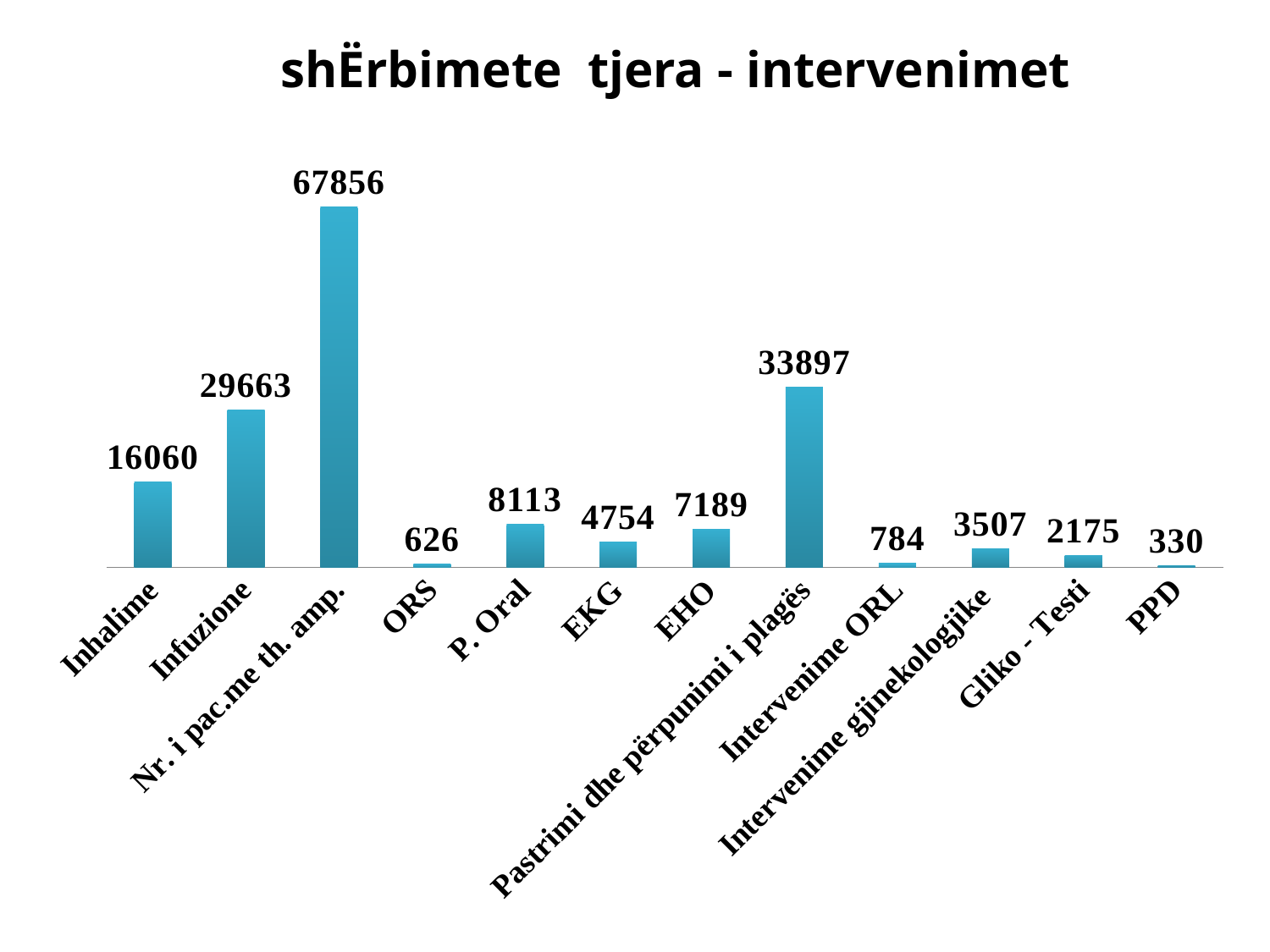
What is the value for EKG? 4754 Which category has the highest value? Nr. i pac.me th. amp. What is the value for Pastrimi dhe përpunimi i plagës? 33897 What is the value for Inhalime? 16060 What kind of chart is shown on the slide? Bar chart What is the difference between the values for Infuzione and Inhalime? 13603 How many categories are shown in the chart? 12 Which category has the lowest value? PPD Which is larger, the value for Intervenime ORL or the value for ORS? Intervenime ORL What is the value for Gliko - Testi? 2175 Which is larger, the value for EHO or the value for Intervenime gjinekologjike? EHO What is the difference between the values for P. Oral and EHO? 924